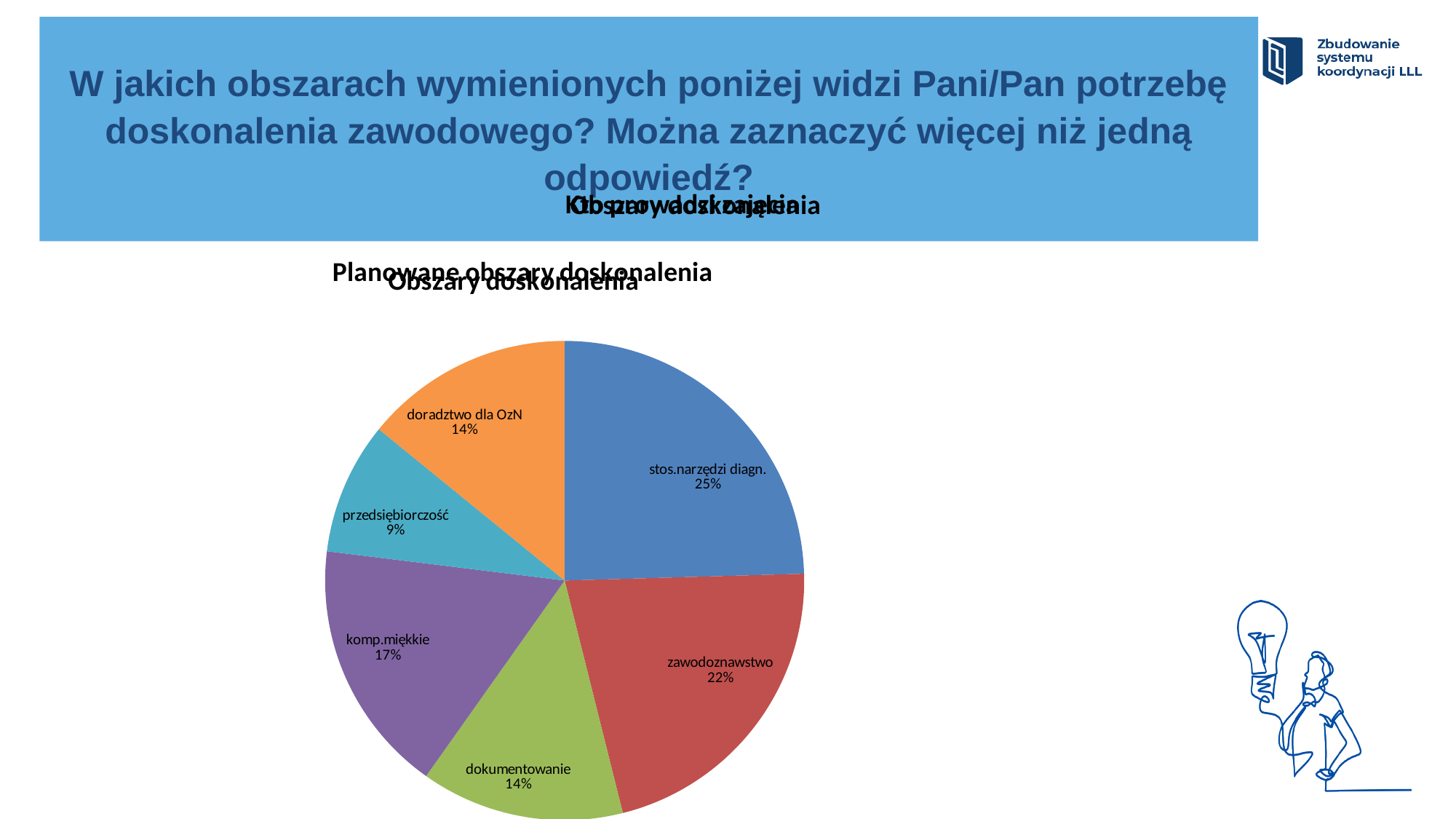
What colour is the slice for "zawodoznawstwo"? red What share of the pie does "stos.narzędzi diagn." have? 25% What share of the pie does "zawodoznawstwo" have? 22% Which category has the largest slice of the pie? stos.narzędzi diagn. Which category has the smallest slice of the pie? przedsiębiorczość Which is larger, the slice for "komp.miękkie" or the slice for "dokumentowanie"? komp.miękkie What share of the pie does "komp.miękkie" have? 17% What is the difference in percentage points between "stos.narzędzi diagn." and "zawodoznawstwo"? 3 How many slices does the pie chart have? 6 What share of the pie does "przedsiębiorczość" have? 9% What kind of chart is shown on the slide? pie chart What share of the pie does "doradztwo dla OzN" have? 14%